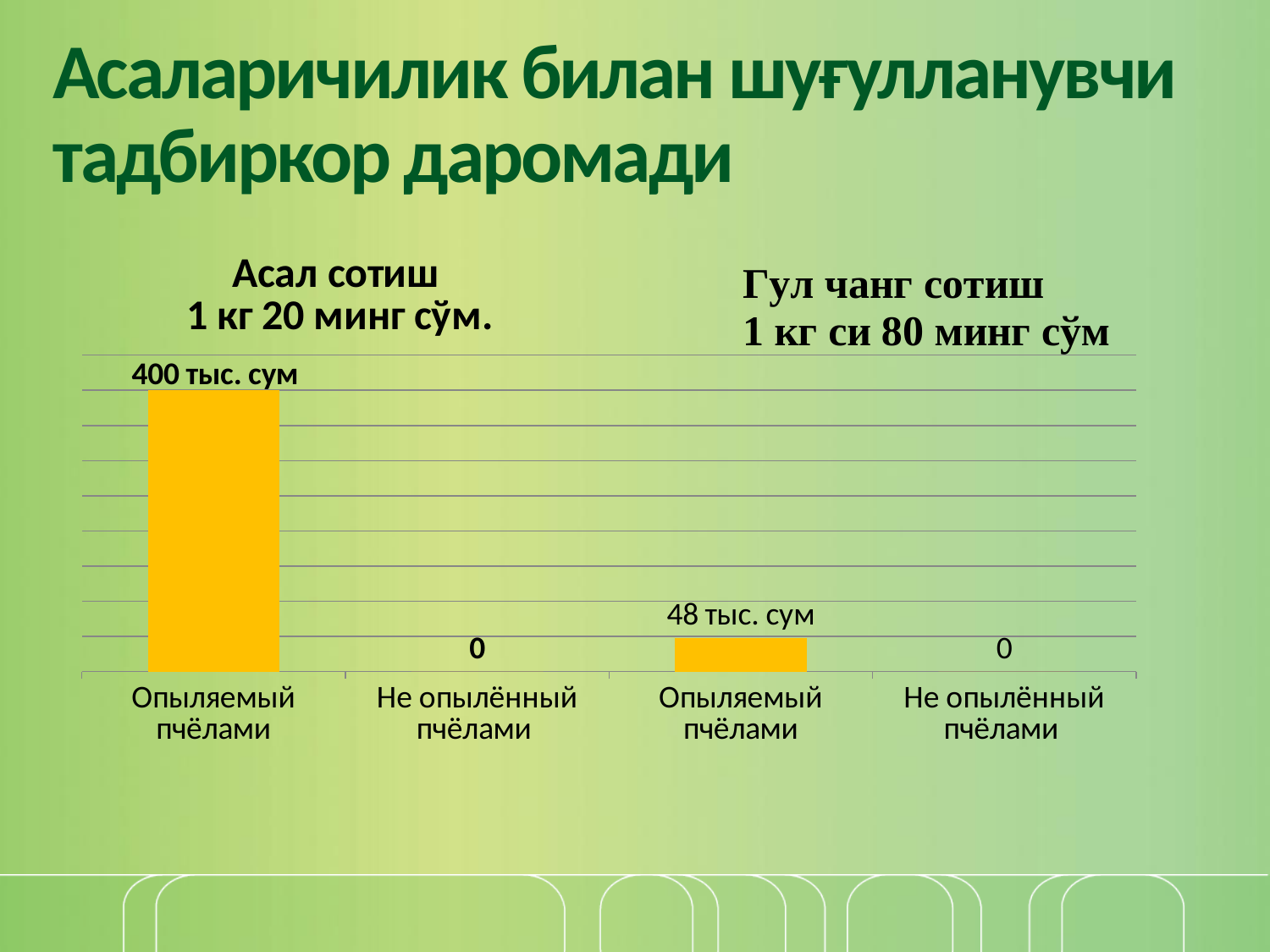
What is the value of the bar for "Не опылённый пчёлами" under "Асал сотиш" (honey sales)? 0 Which is larger: the "Опыляемый пчёлами" bar for honey sales (Асал сотиш) or for pollen sales (Гул чанг сотиш)? Асал сотиш (honey sales) According to the text above the chart, what is the price of 1 kg of pollen (Гул чанг сотиш)? 80 минг сўм How many bars (categories) are plotted in the chart? 4 What is the value of the bar for "Опыляемый пчёлами" under "Гул чанг сотиш" (pollen sales)? 48 тыс. сум What is the total of the two "Опыляемый пчёлами" bars (honey sales and pollen sales)? 448 тыс. сум What type of chart is shown on the slide? bar chart What is the value of the bar for "Опыляемый пчёлами" under "Асал сотиш" (honey sales)? 400 тыс. сум Which bar has the highest value in the chart? Опыляемый пчёлами (Асал сотиш) What is the value of the bar for "Не опылённый пчёлами" under "Гул чанг сотиш" (pollen sales)? 0 What is the difference between the "Опыляемый пчёлами" value for honey sales (Асал сотиш) and for pollen sales (Гул чанг сотиш)? 352 тыс. сум According to the text above the chart, what is the price of 1 kg of honey (Асал сотиш)? 20 минг сўм